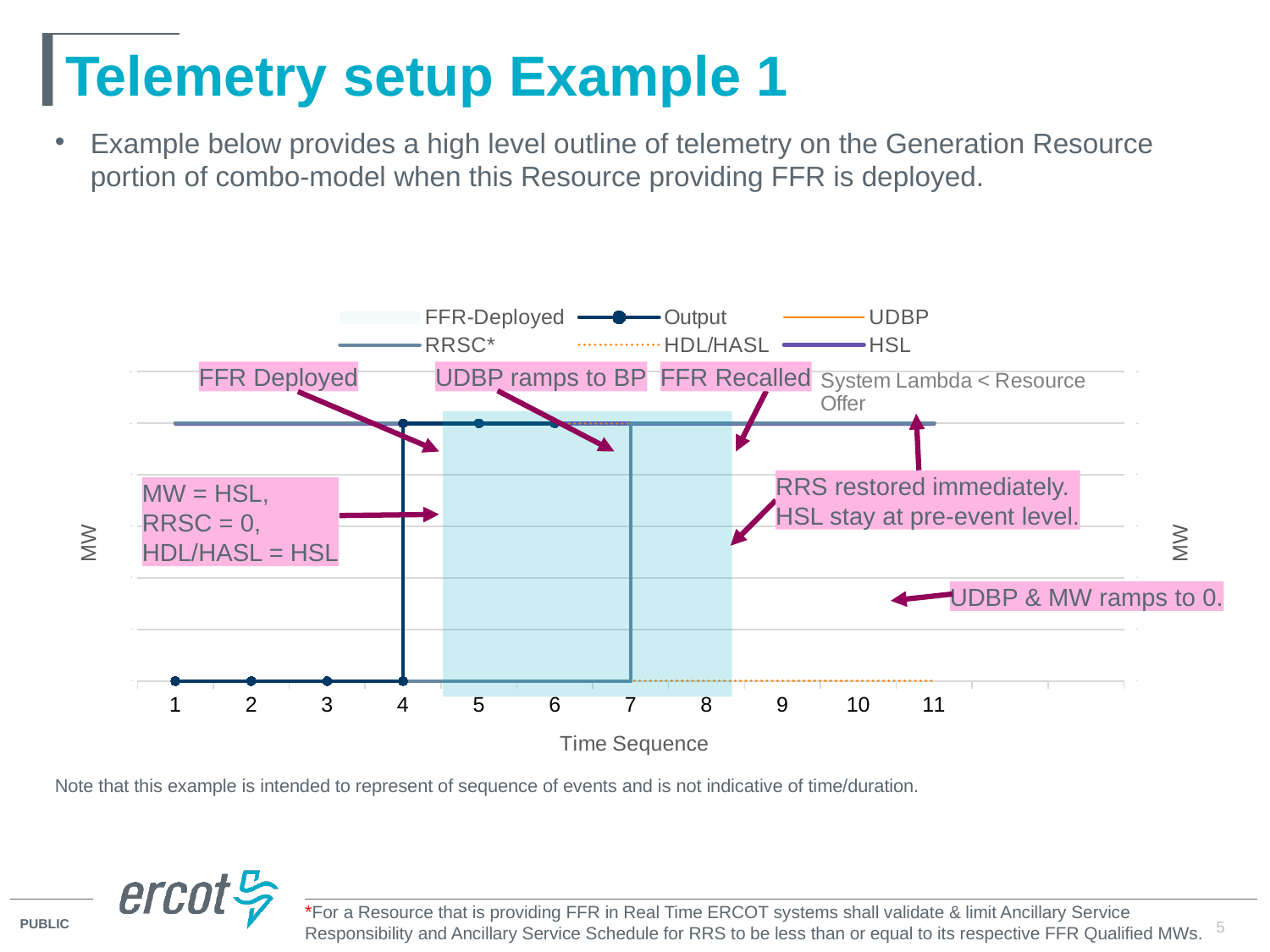
How many series does the chart legend list? 6 What is the title of the x axis? Time Sequence Is the Output value at time sequence 5 higher or lower than at time sequence 2? higher Does the Output series rise, fall, or stay flat between time sequence 1 and time sequence 3? stay flat Does the Output series rise or fall at time sequence 7? fall What is the label on the y axis of the chart? MW What kind of chart is shown on the slide? combination bar and line chart How many time sequence points are labeled on the x axis? 11 Does the Output series rise or fall at time sequence 4? rise